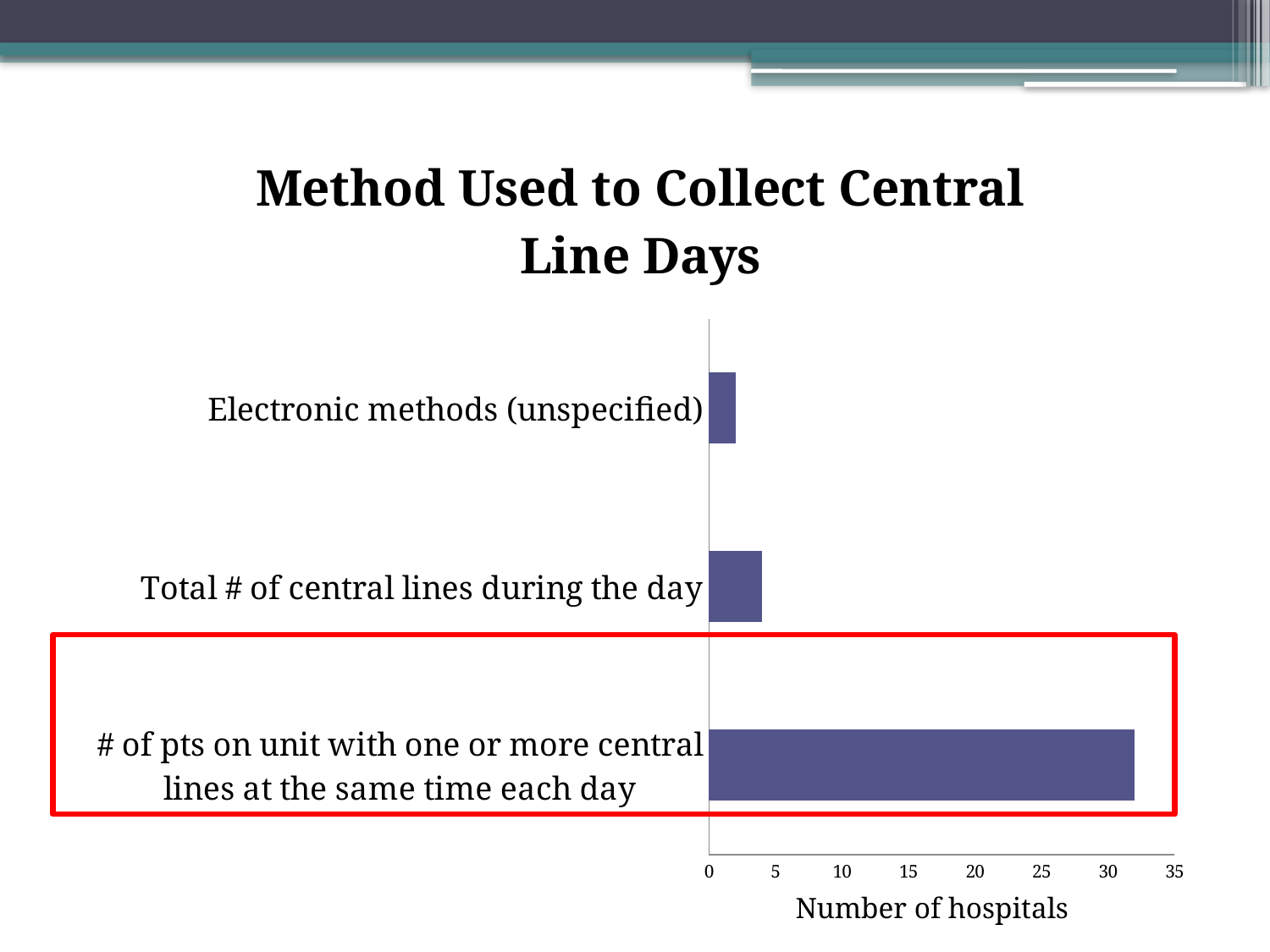
What is the label of the horizontal axis? Number of hospitals Which method has the lowest number of hospitals? Electronic methods (unspecified) What is the title of the chart? Method Used to Collect Central Line Days Which has more hospitals: '# of pts on unit with one or more central lines at the same time each day' or 'Total # of central lines during the day'? # of pts on unit with one or more central lines at the same time each day Is the number of hospitals for 'Total # of central lines during the day' greater or less than 5? less Is the number of hospitals for '# of pts on unit with one or more central lines at the same time each day' greater or less than 35? less What kind of chart is shown on the slide? bar chart How many categories (methods) are plotted in the chart? 3 Which has more hospitals: 'Total # of central lines during the day' or 'Electronic methods (unspecified)'? Total # of central lines during the day Which method has the highest number of hospitals? # of pts on unit with one or more central lines at the same time each day Is the number of hospitals for 'Electronic methods (unspecified)' greater or less than 5? less